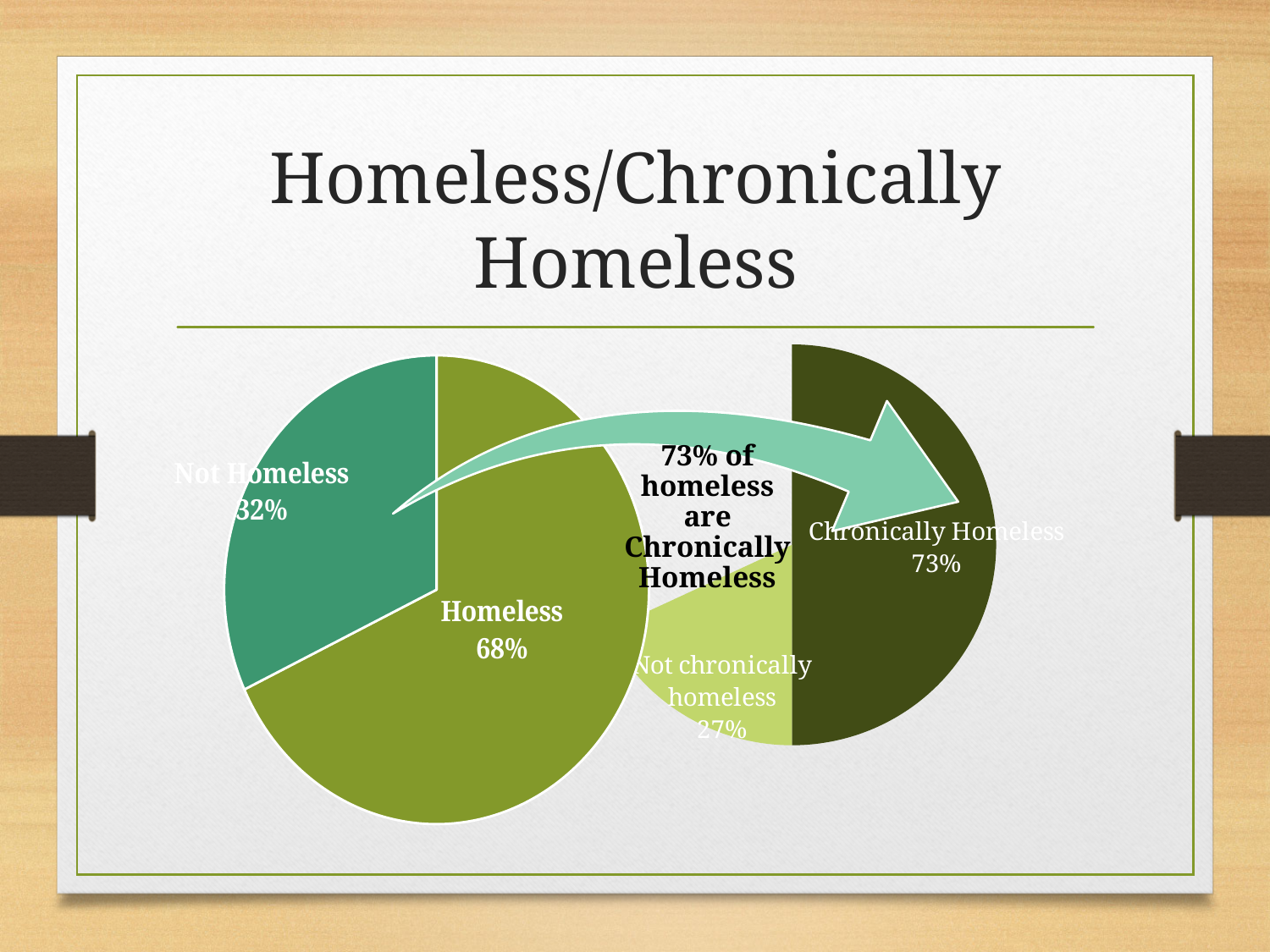
In the left pie chart, which slice is larger, Homeless or Not Homeless? Homeless What is the title of the slide containing the two pie charts? Homeless/Chronically Homeless In the right pie chart, which slice is the smallest? Not chronically homeless In the left pie chart, what share is labelled Not Homeless? 32% In the left pie chart, what is the difference between the Homeless and Not Homeless shares? 36% What does the text on the arrow between the two pie charts say? 73% of homeless are Chronically Homeless In the right pie chart, what share is labelled Not chronically homeless? 27% How many slices does the left pie chart have? 2 In the right pie chart, what share is labelled Chronically Homeless? 73% What type of chart is the right chart on the slide? Pie chart In the left pie chart, what share is labelled Homeless? 68% In the right pie chart, what is the difference between the Chronically Homeless and Not chronically homeless shares? 46%